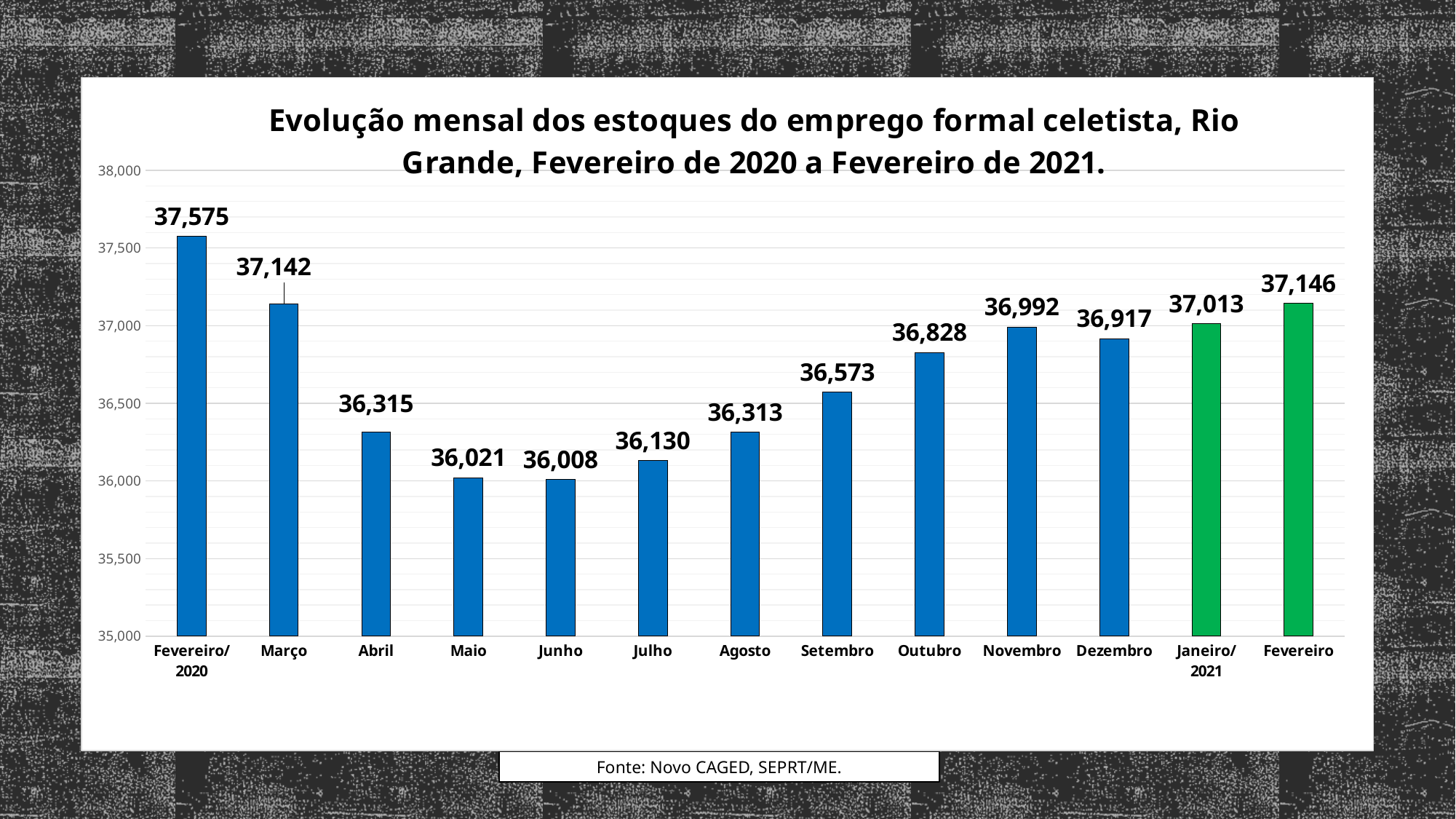
What is the difference between the values for Fevereiro/2020 and Fevereiro (2021)? 429 How many months are shown on the chart? 13 Is the value for Outubro greater or less than 37,000? less What is the difference between the values for Novembro and Dezembro? 75 What kind of chart is shown on the slide? bar chart What is the value for Fevereiro (2021)? 37,146 Do the values rise or fall from Junho to Novembro? rise Which month has the lowest value? Junho Which month has the highest value? Fevereiro/2020 What is the value for Fevereiro/2020? 37,575 Which is larger, the value for Março or the value for Fevereiro (2021)? Fevereiro (2021) What is the value for Junho? 36,008